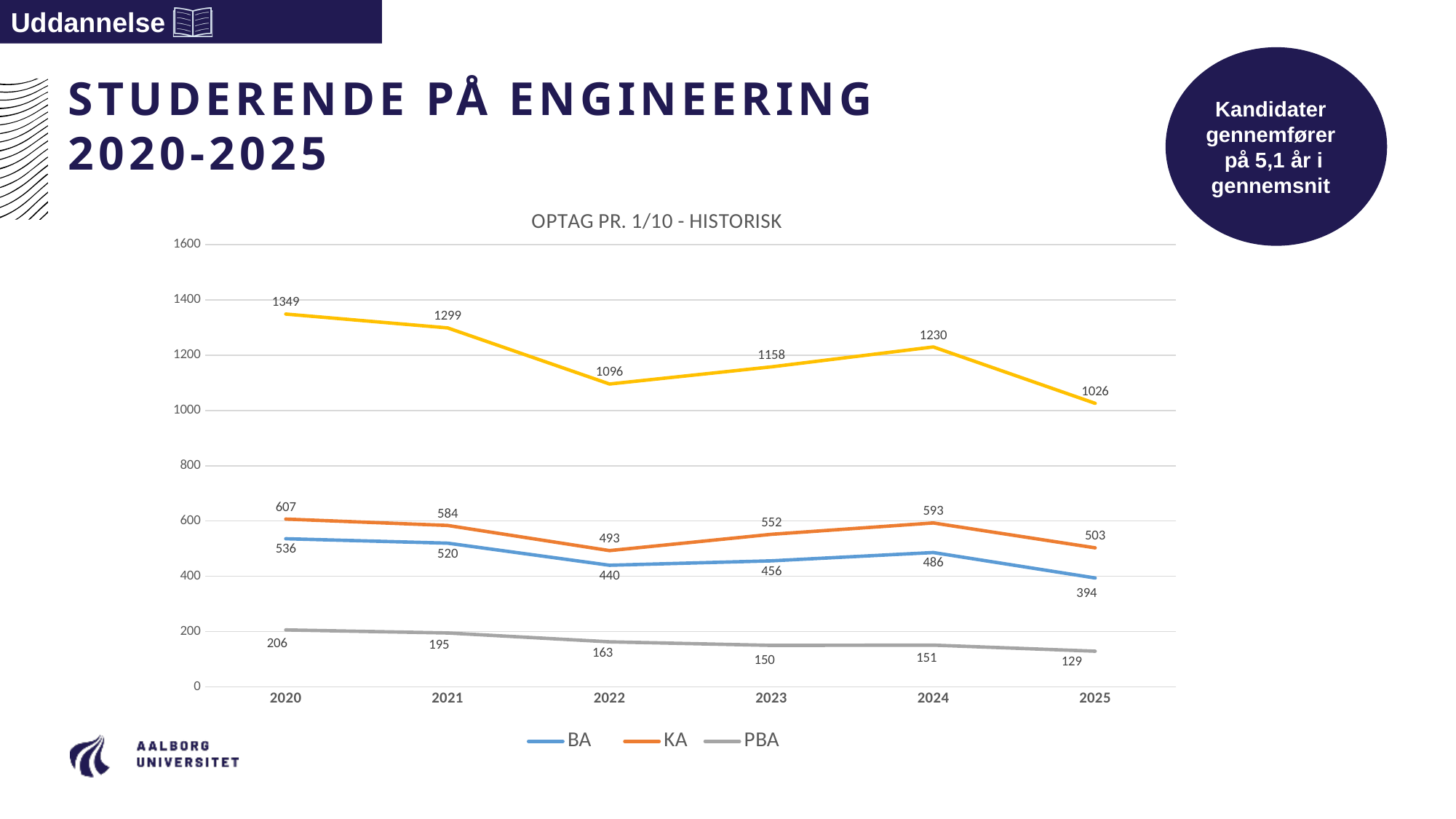
How many series does the chart legend list? 3 Which is larger in 2022, the BA value or the PBA value? BA In which year is the KA value highest? 2020 In which year is the BA value lowest? 2025 Does the PBA series rise or fall from 2020 to 2025? fall What type of chart is shown on the slide? line chart What is the value for BA in 2025? 394 What is the value for KA in 2020? 607 What is the difference between the KA and BA values in 2024? 107 What is the value for PBA in 2023? 150 How many years are shown on the x axis of the chart? 6 What is the title of the chart? OPTAG PR. 1/10 - HISTORISK